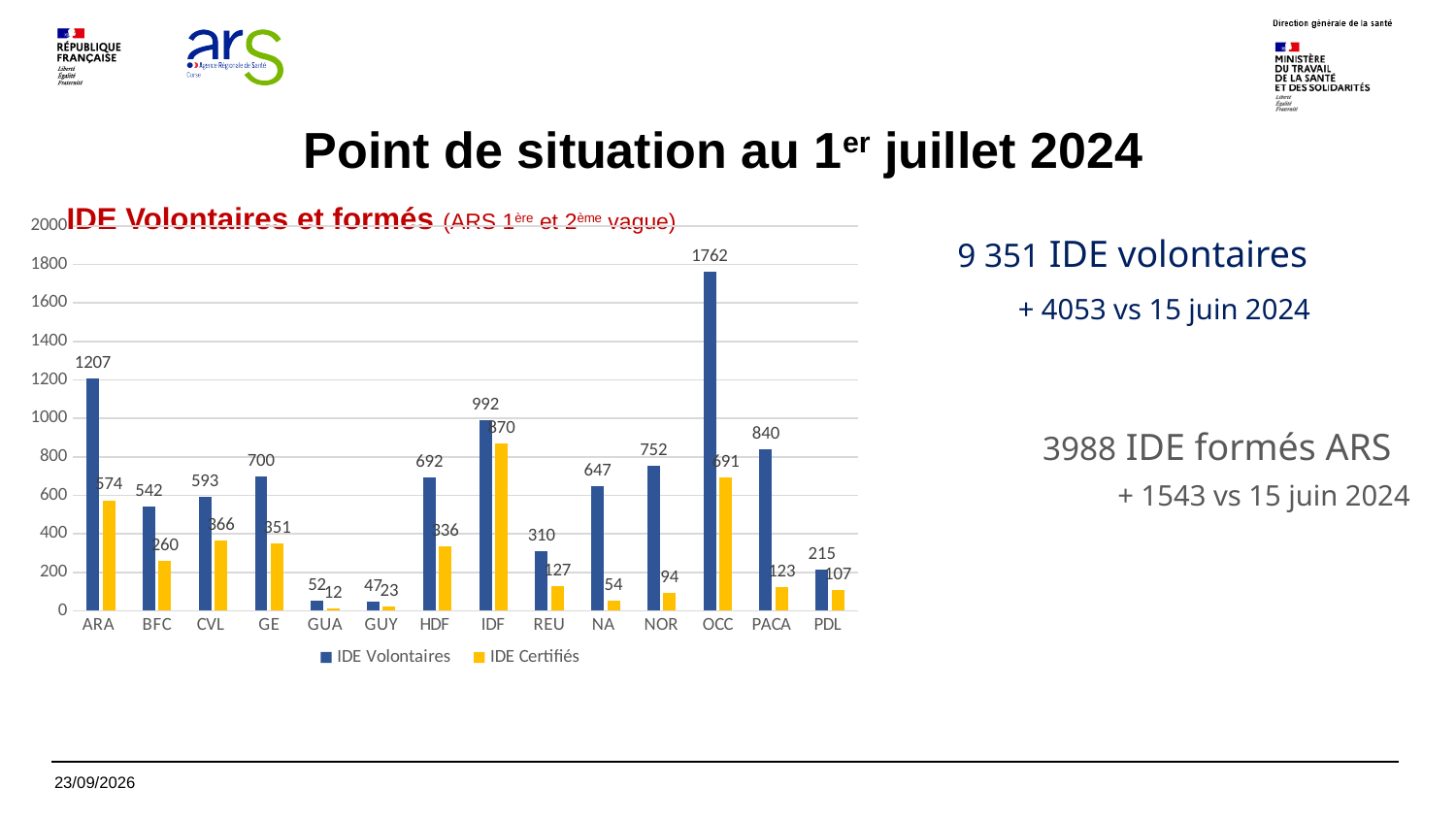
What type of chart is shown on the slide? bar chart What is the value of IDE Certifiés for NA? 54 What is the difference between IDE Volontaires and IDE Certifiés for GUY? 24 How many series does the chart legend list? 2 How many regions (categories) are shown on the x axis of the chart? 14 Which region has the lowest value of IDE Certifiés? GUA What is the value of IDE Volontaires for ARA? 1207 Which is larger: IDE Volontaires for PACA or for NOR? PACA Is the value of IDE Volontaires for IDF greater or less than 800? greater What is the value of IDE Volontaires for OCC? 1762 Which region has the highest value of IDE Volontaires? OCC What is the difference between IDE Volontaires for OCC and for ARA? 555